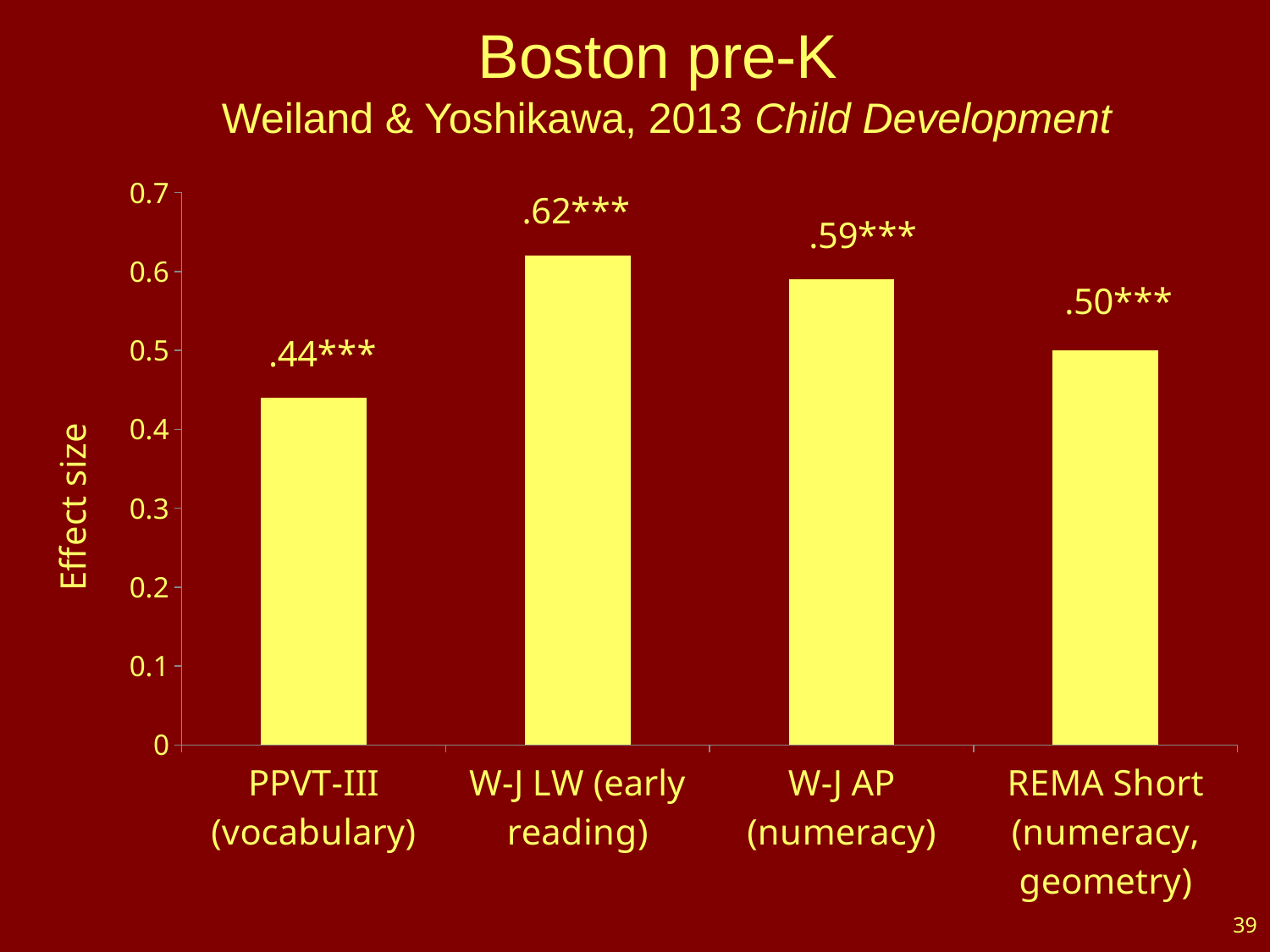
What is the effect size for W-J LW (early reading)? .62*** Which has a larger effect size, W-J AP (numeracy) or REMA Short (numeracy, geometry)? W-J AP (numeracy) How many measures are shown in the chart? 4 Which measure has the highest effect size? W-J LW (early reading) What is the label on the vertical axis? Effect size What kind of chart is shown on the slide? bar chart What is the difference between the effect sizes for W-J LW (early reading) and PPVT-III (vocabulary)? .18 Is the effect size for REMA Short (numeracy, geometry) greater or less than 0.4? greater What is the effect size for PPVT-III (vocabulary)? .44*** What is the effect size for W-J AP (numeracy)? .59*** What is the effect size for REMA Short (numeracy, geometry)? .50*** Which measure has the lowest effect size? PPVT-III (vocabulary)